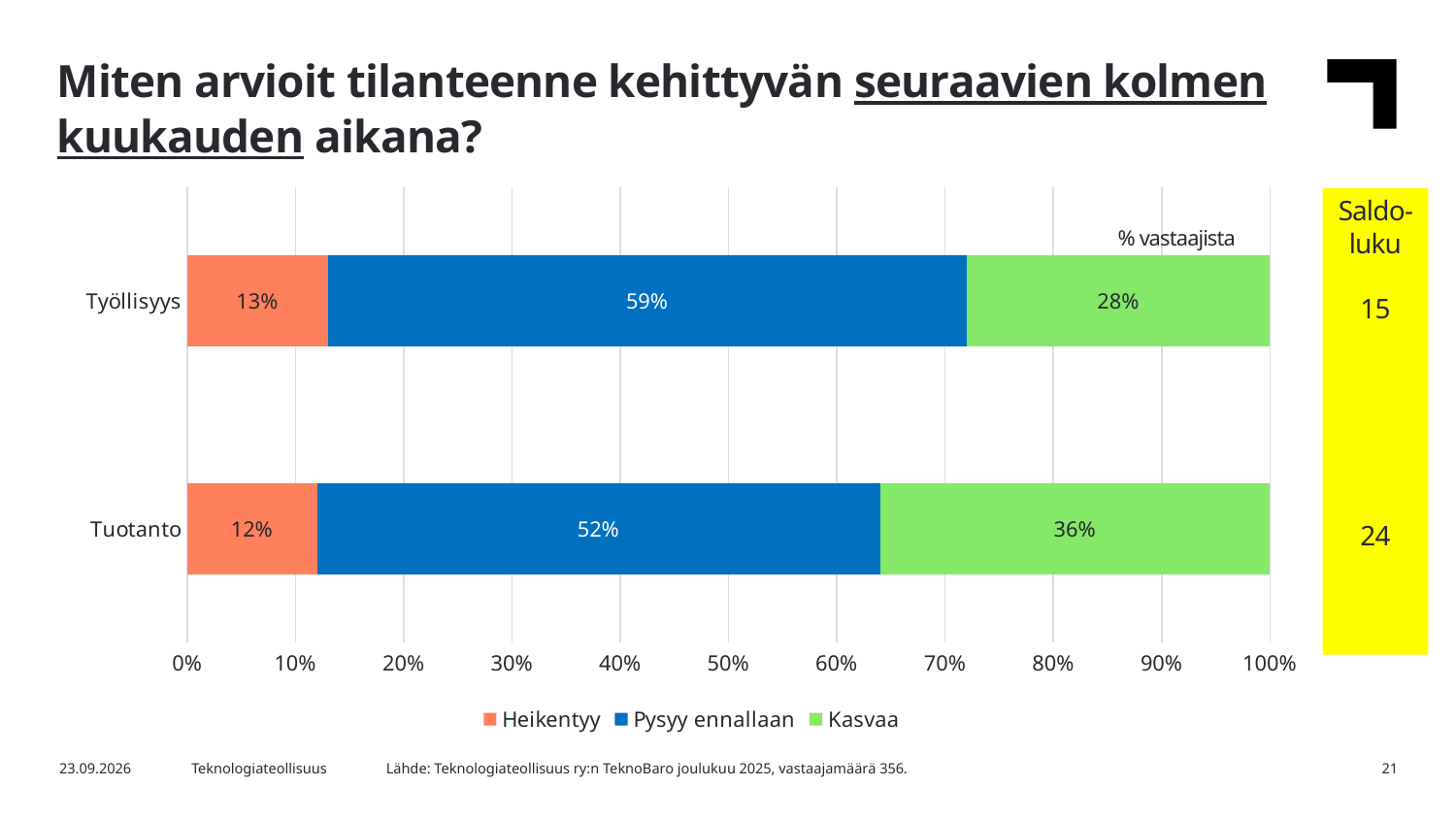
What is the total of the stacked bar for Työllisyys? 100% Which category has the higher Kasvaa share, Työllisyys or Tuotanto? Tuotanto What percentage of respondents expect Työllisyys to stay the same (Pysyy ennallaan)? 59% What is the difference between the Pysyy ennallaan shares for Työllisyys and Tuotanto? 7 percentage points How many series does the legend list? 3 What is the difference between the Kasvaa shares for Tuotanto and Työllisyys? 8 percentage points What is the Saldoluku value shown for Työllisyys? 15 How many categories are shown on the y axis of the chart? 2 What kind of chart is shown on the slide? Stacked bar chart Which legend entry is shown in green? Kasvaa What percentage of respondents expect Tuotanto to weaken (Heikentyy)? 12% What percentage of respondents expect Tuotanto to grow (Kasvaa)? 36%